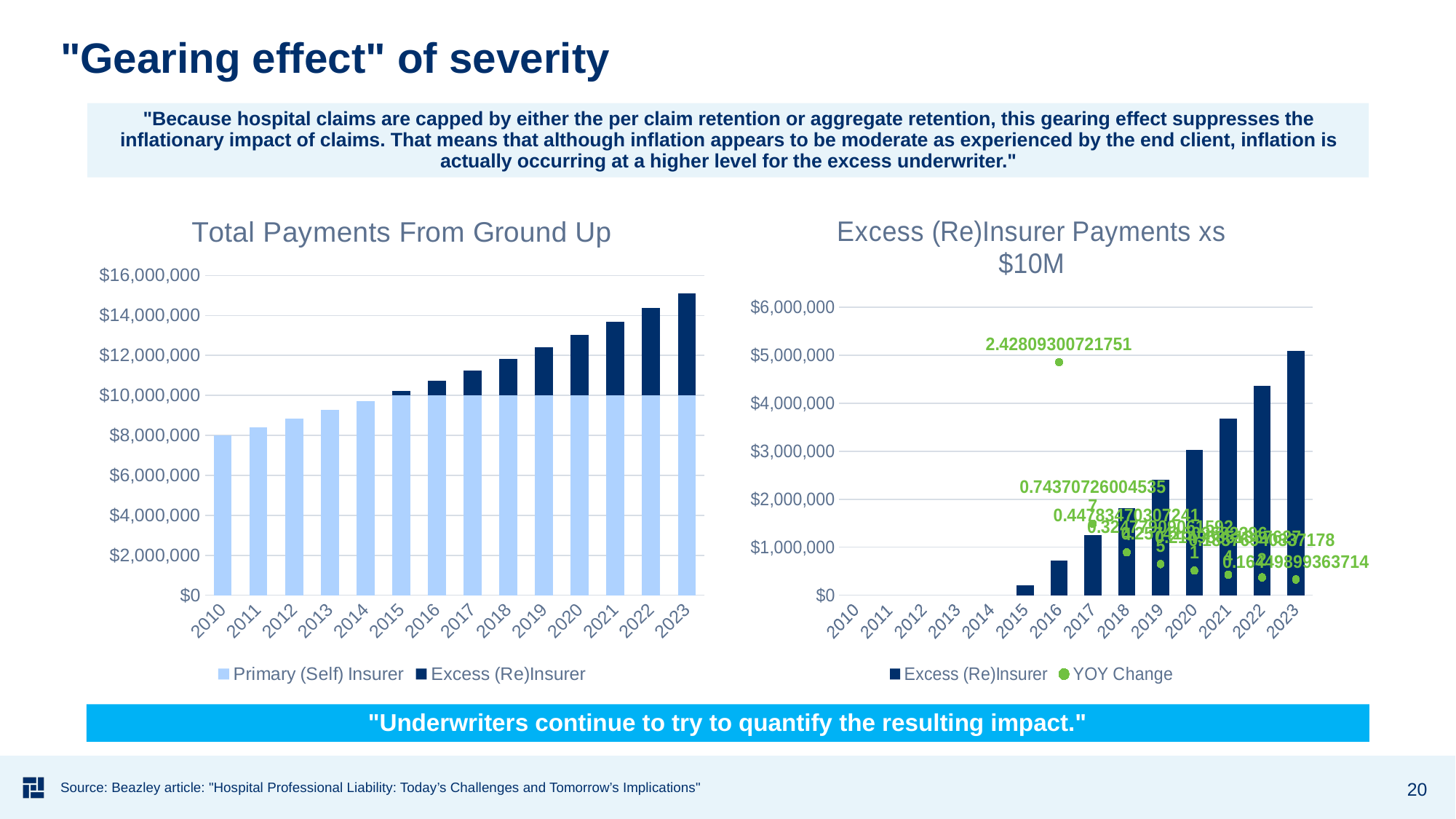
In the "Excess (Re)Insurer Payments xs $10M" chart, which year has the highest Excess (Re)Insurer payment? 2023 In the "Total Payments From Ground Up" chart, is the total for 2023 greater or less than $14,000,000? greater In the "Total Payments From Ground Up" chart, is the total for 2010 greater or less than $10,000,000? less What two series does the legend of the "Excess (Re)Insurer Payments xs $10M" chart list? Excess (Re)Insurer and YOY Change In the "Total Payments From Ground Up" chart, do the total payments rise or fall from 2010 to 2023? Rise What kind of chart is the "Total Payments From Ground Up" chart? Stacked bar chart In the "Excess (Re)Insurer Payments xs $10M" chart, what is the YOY Change data label shown for 2016? 2.42809300721751 How many years are shown on the x axis of the "Total Payments From Ground Up" chart? 14 In the "Excess (Re)Insurer Payments xs $10M" chart, which is larger, the Excess (Re)Insurer payment for 2022 or for 2021? 2022 In the "Excess (Re)Insurer Payments xs $10M" chart, is the Excess (Re)Insurer payment for 2021 greater or less than $3,000,000? greater How many series does the legend of the "Total Payments From Ground Up" chart list? 2 In the "Total Payments From Ground Up" chart, which year has the highest total payments? 2023